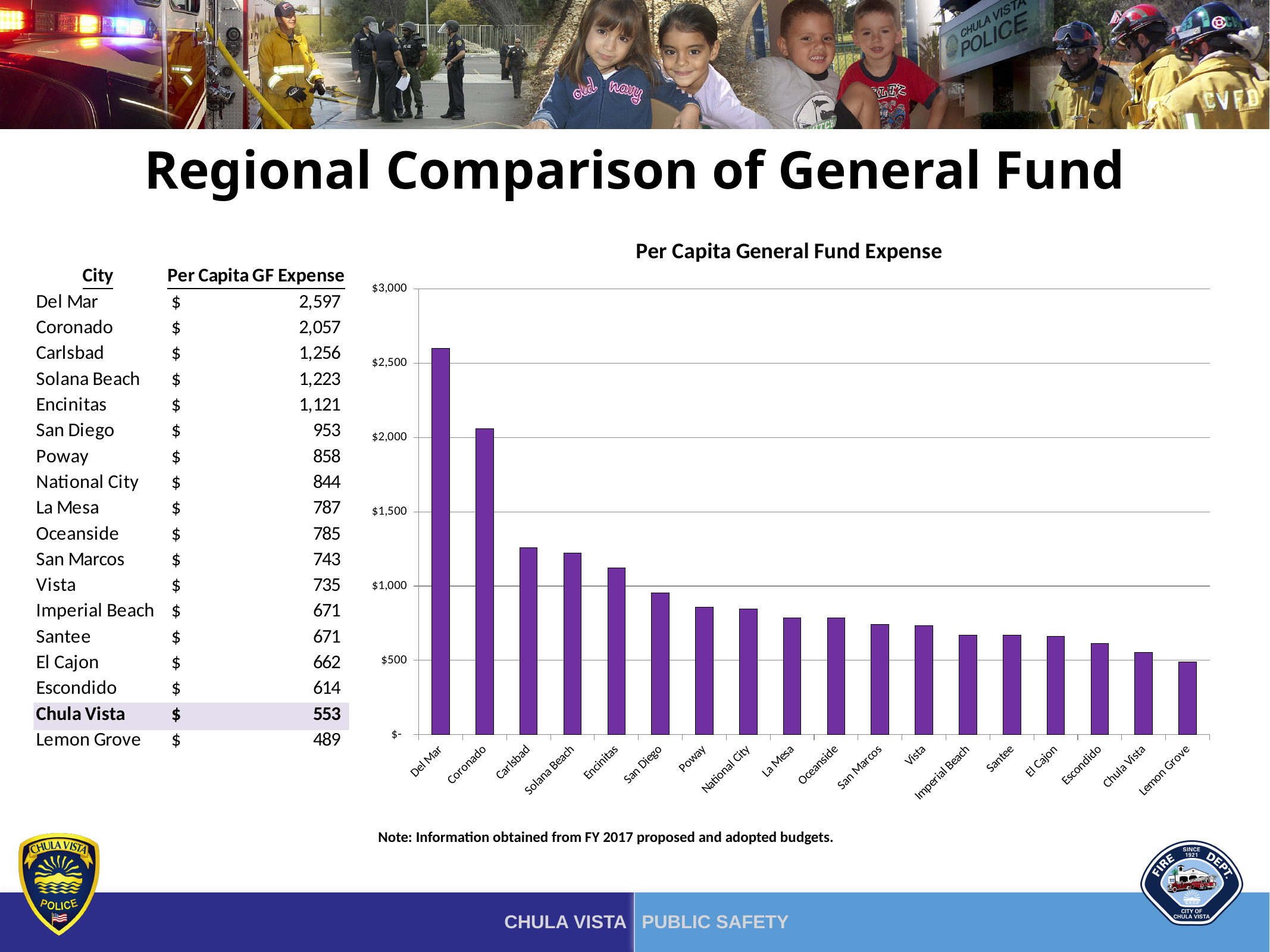
What is the difference between Del Mar's and Coronado's per capita general fund expense? $540 Do the bar values rise or fall moving from left to right along the x axis? Fall What type of chart is shown on the slide? Bar chart How many cities are plotted in the chart? 18 Which has a higher per capita general fund expense, San Diego or Poway? San Diego Is the value for Carlsbad greater or less than $1,000? greater What is the per capita general fund expense for Coronado? $2,057 What is the title of the chart? Per Capita General Fund Expense What is the difference between Escondido's and Chula Vista's per capita general fund expense? $61 What is the per capita general fund expense for Chula Vista? $553 Which city has the lowest per capita general fund expense? Lemon Grove Which city has the highest per capita general fund expense? Del Mar